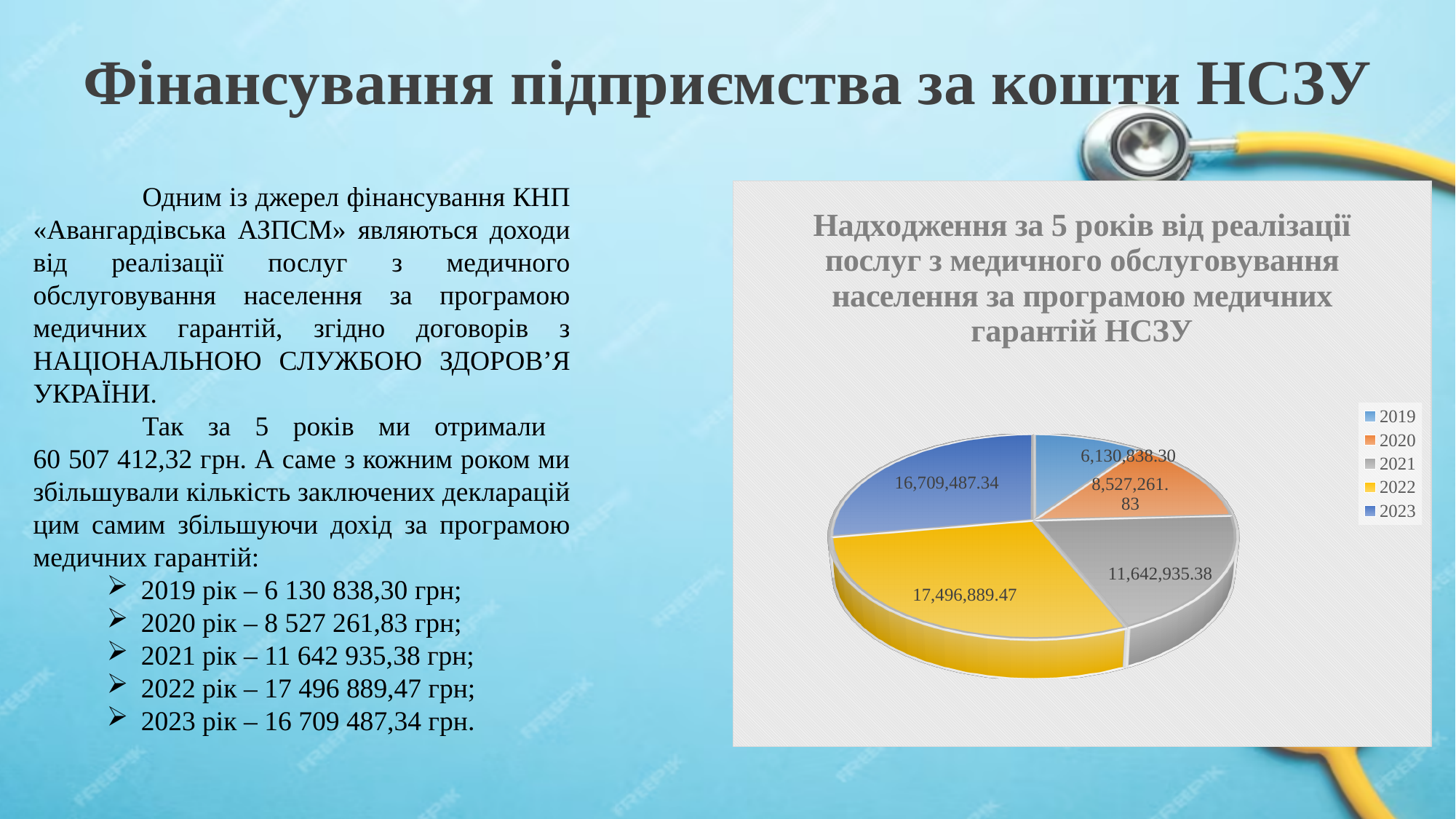
Which is larger, the value for 2022 or the value for 2023? 2022 What is the value for 2023 in the pie chart? 16,709,487.34 What is the value for 2019 in the pie chart? 6,130,838.30 Which year has the largest slice in the pie chart? 2022 What is the difference between the values for 2021 and 2020? 3,115,673.55 What is the value for 2020 in the pie chart? 8,527,261.83 What is the difference between the values for 2022 and 2023? 787,402.13 How many slices does the pie chart have? 5 What type of chart is shown on the slide? Pie chart Which year has the smallest slice in the pie chart? 2019 How many entries does the legend list? 5 What is the value for 2021 in the pie chart? 11,642,935.38